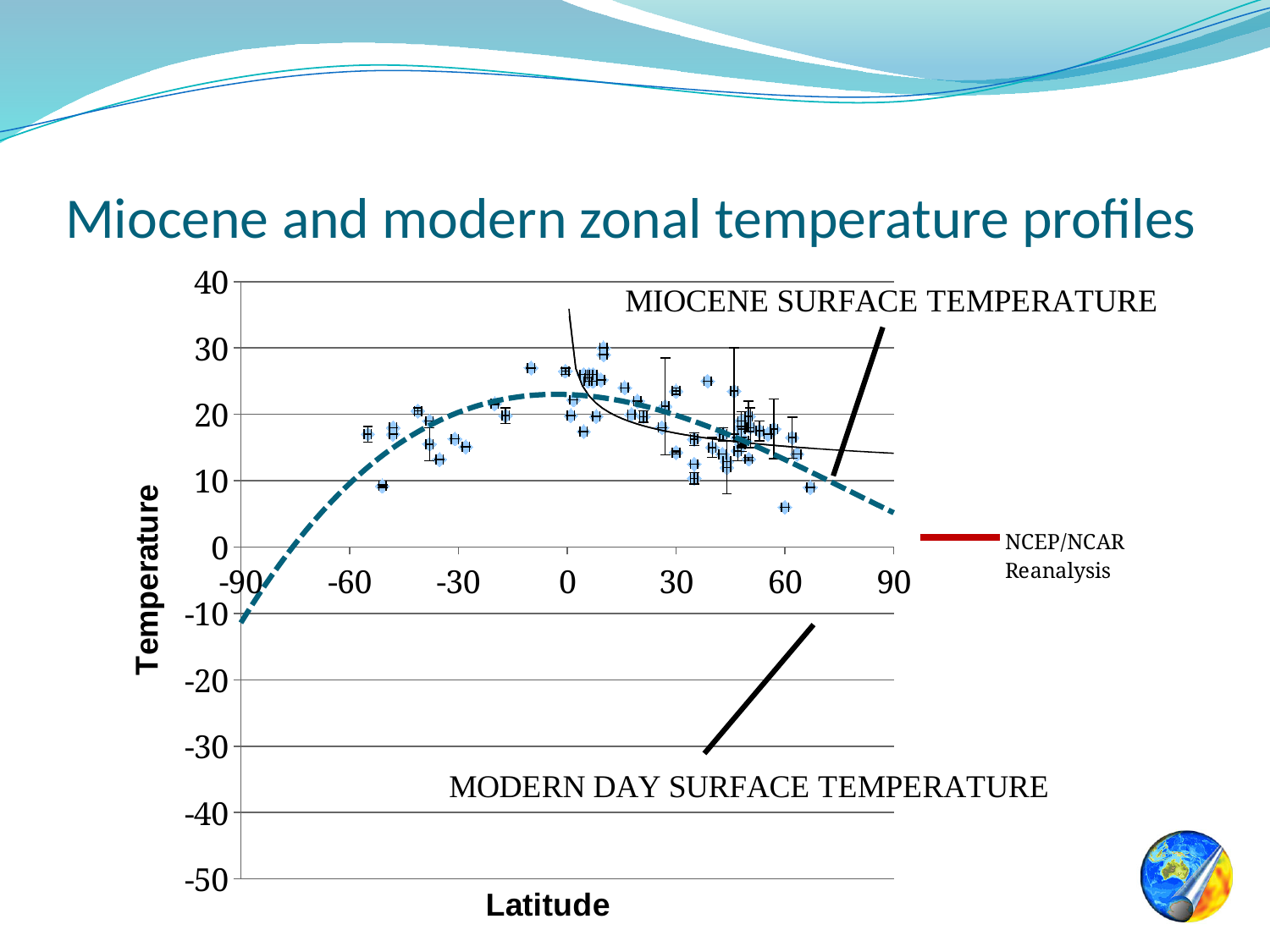
How many tick labels are shown on the y axis? 10 Does the dashed Miocene surface temperature line rise or fall as latitude goes from -90 to 0? rise Is the value of the dashed Miocene surface temperature line at latitude 0 greater or less than 10? greater What kind of chart is shown on the slide? scatter chart What is the label of the x axis? Latitude Is the value of the dashed Miocene surface temperature line at latitude 90 greater or less than 20? less At latitude 0, which line is higher: the dashed Miocene surface temperature line or the thin modern day surface temperature line? modern day surface temperature line How many tick labels are shown on the x axis? 7 Is the value of the dashed Miocene surface temperature line at latitude -90 greater or less than 0? less What is the label of the y axis? Temperature What is the highest tick value shown on the y axis? 40 Does the dashed Miocene surface temperature line rise or fall as latitude goes from 0 to 90? fall